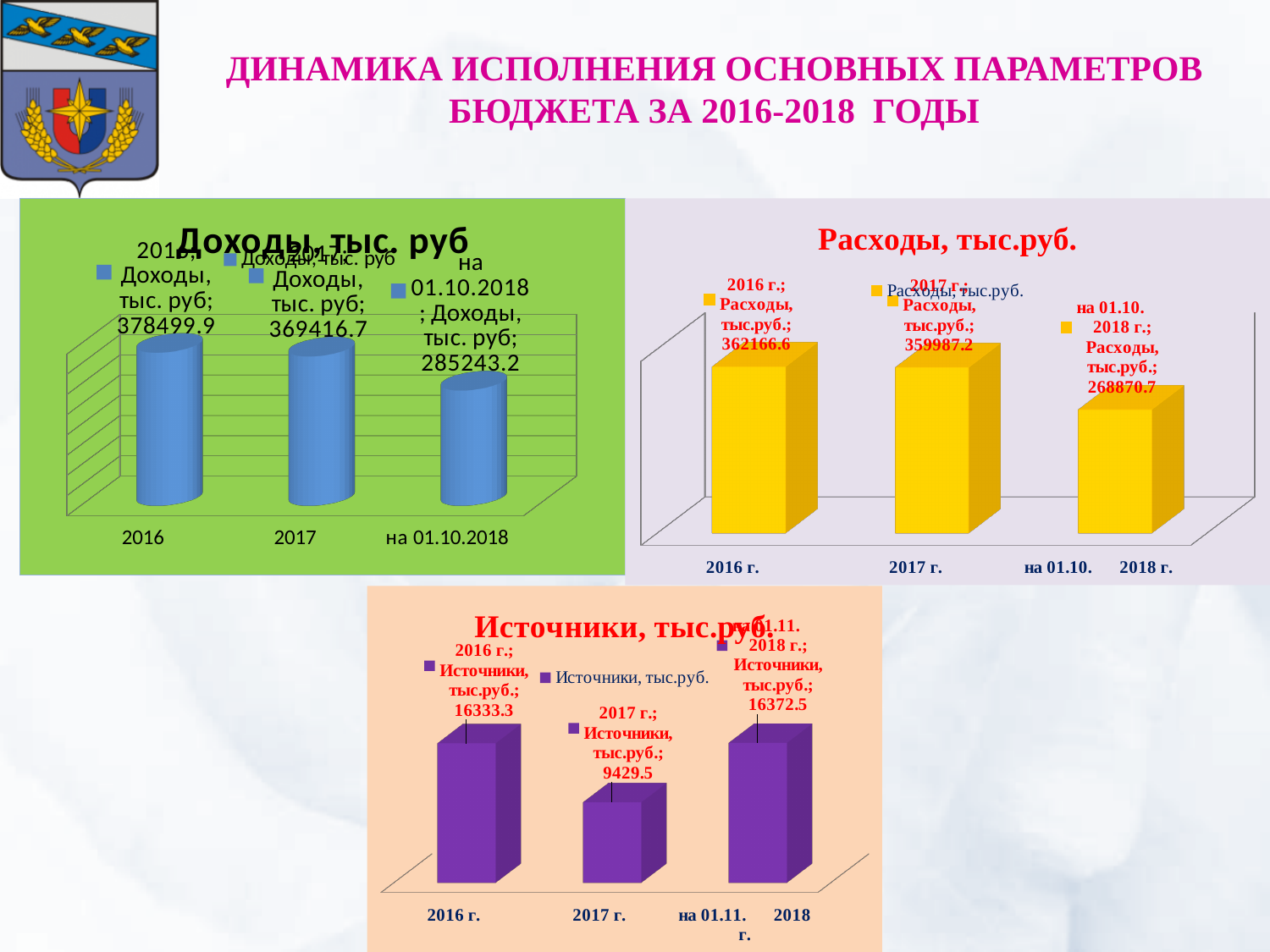
What type of chart is the Источники, тыс.руб. chart? bar chart In the Доходы, тыс. руб chart, what is the difference between the 2016 and 2017 values? 9083.2 In the Расходы, тыс.руб. chart, what is the value for 2017 г.? 359987.2 In the Расходы, тыс.руб. chart, which category has the highest value? 2016 г. In the Доходы, тыс. руб chart, what is the value for 2016? 378499.9 How many categories are shown in the Расходы, тыс.руб. chart? 3 In the Источники, тыс.руб. chart, what is the value for 2017 г.? 9429.5 In the Источники, тыс.руб. chart, which category has the lowest value? 2017 г. In the Доходы, тыс. руб chart, what is the value for на 01.10.2018? 285243.2 In the Источники, тыс.руб. chart, what is the difference between the 2016 г. and 2017 г. values? 6903.8 In the Расходы, тыс.руб. chart, what is the difference between the 2016 г. and 2017 г. values? 2179.4 In the Доходы, тыс. руб chart, which category has the lowest value? на 01.10.2018